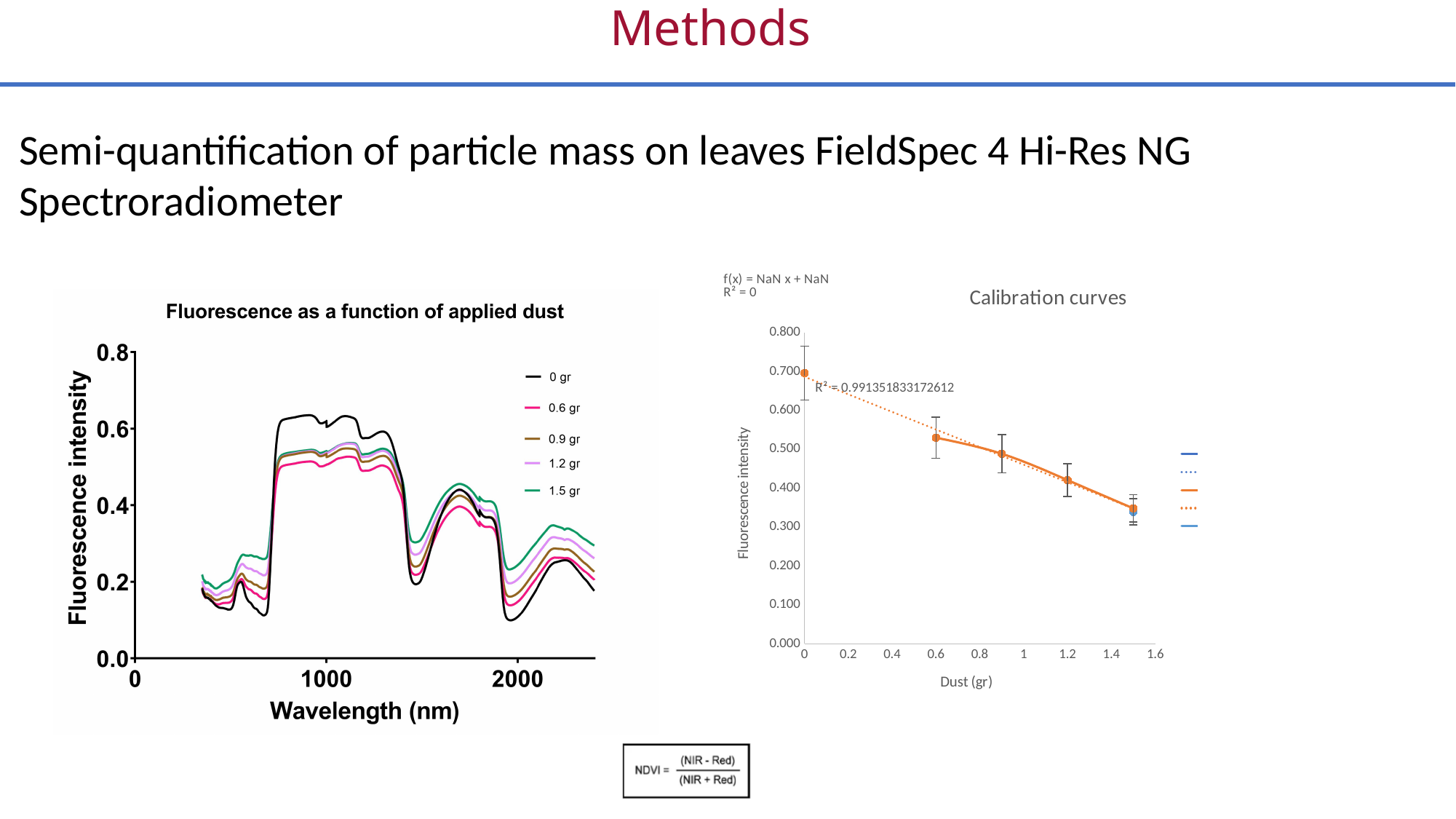
In the left chart 'Fluorescence as a function of applied dust', how many series does the legend list? 5 In the right chart 'Calibration curves', is the fluorescence intensity at 0 gr dust greater or less than 0.600? greater In the right chart 'Calibration curves', is the fluorescence intensity at 1.5 gr dust greater or less than 0.400? less In the left chart 'Fluorescence as a function of applied dust', is the value of the 0 gr series at 1000 nm greater or less than 0.6? greater In the right chart 'Calibration curves', does fluorescence intensity rise or fall as dust increases? fall In the right chart 'Calibration curves', which dust amount has the lowest fluorescence intensity? 1.5 In the left chart 'Fluorescence as a function of applied dust', which series has the highest fluorescence intensity at 1000 nm? 0 gr In the left chart 'Fluorescence as a function of applied dust', what is the label of the x axis? Wavelength (nm) What kind of chart is the left chart titled 'Fluorescence as a function of applied dust'? line chart